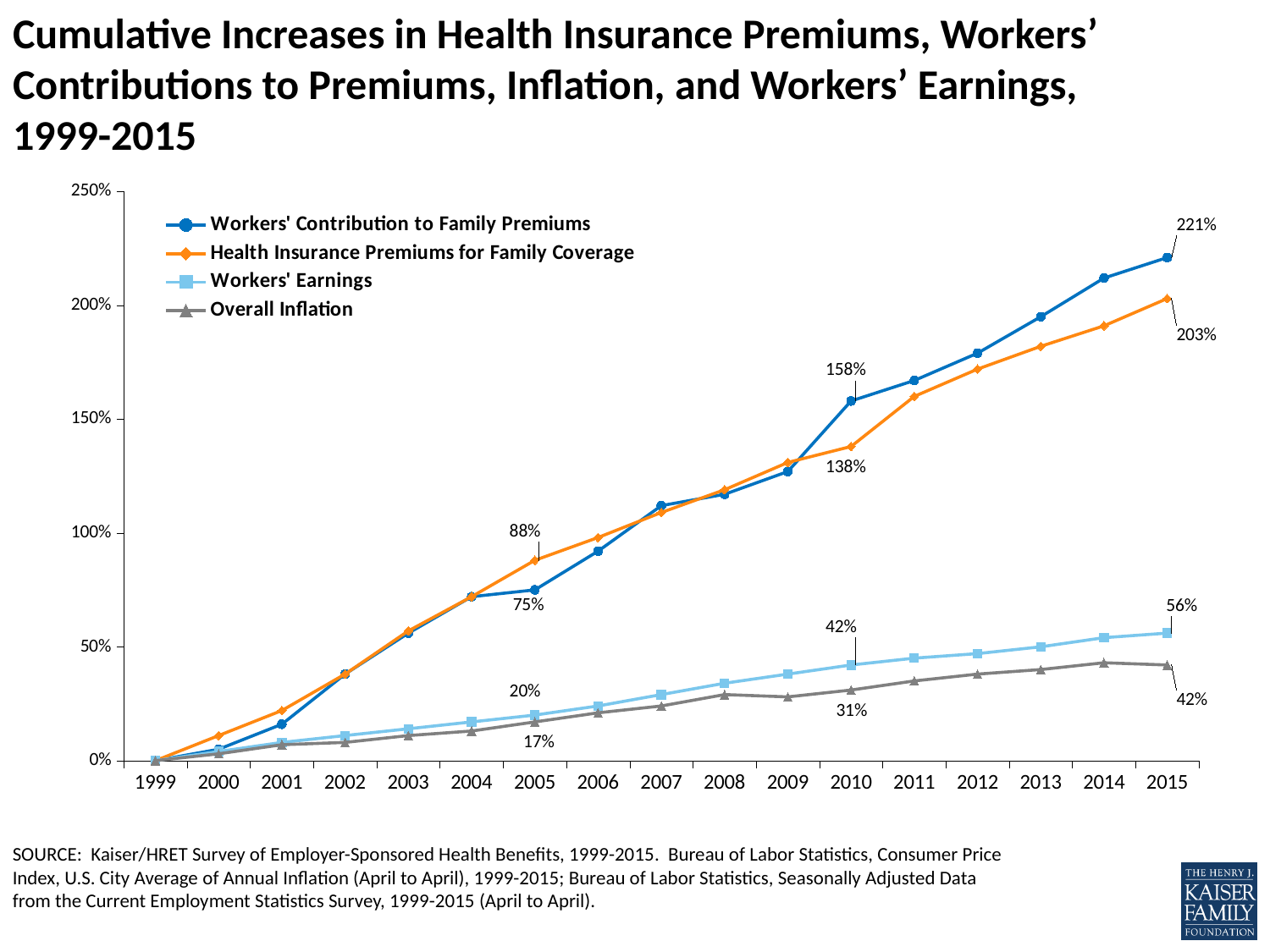
Is the value for Health Insurance Premiums for Family Coverage in 2012 greater or less than 150%? greater What kind of chart is shown on the slide? Line chart What is the difference between Workers' Contribution to Family Premiums and Health Insurance Premiums for Family Coverage in 2015? 18 percentage points What is the value for Workers' Earnings in 2010? 42% In 2010, which is larger: Workers' Contribution to Family Premiums or Health Insurance Premiums for Family Coverage? Workers' Contribution to Family Premiums Which series has the lowest value in 2015? Overall Inflation Which series has the highest value in 2015? Workers' Contribution to Family Premiums What is the value for Workers' Contribution to Family Premiums in 2015? 221% How many years are plotted along the x axis? 17 What is the value for Overall Inflation in 2005? 17% What is the value for Health Insurance Premiums for Family Coverage in 2015? 203% How many series does the legend list? 4